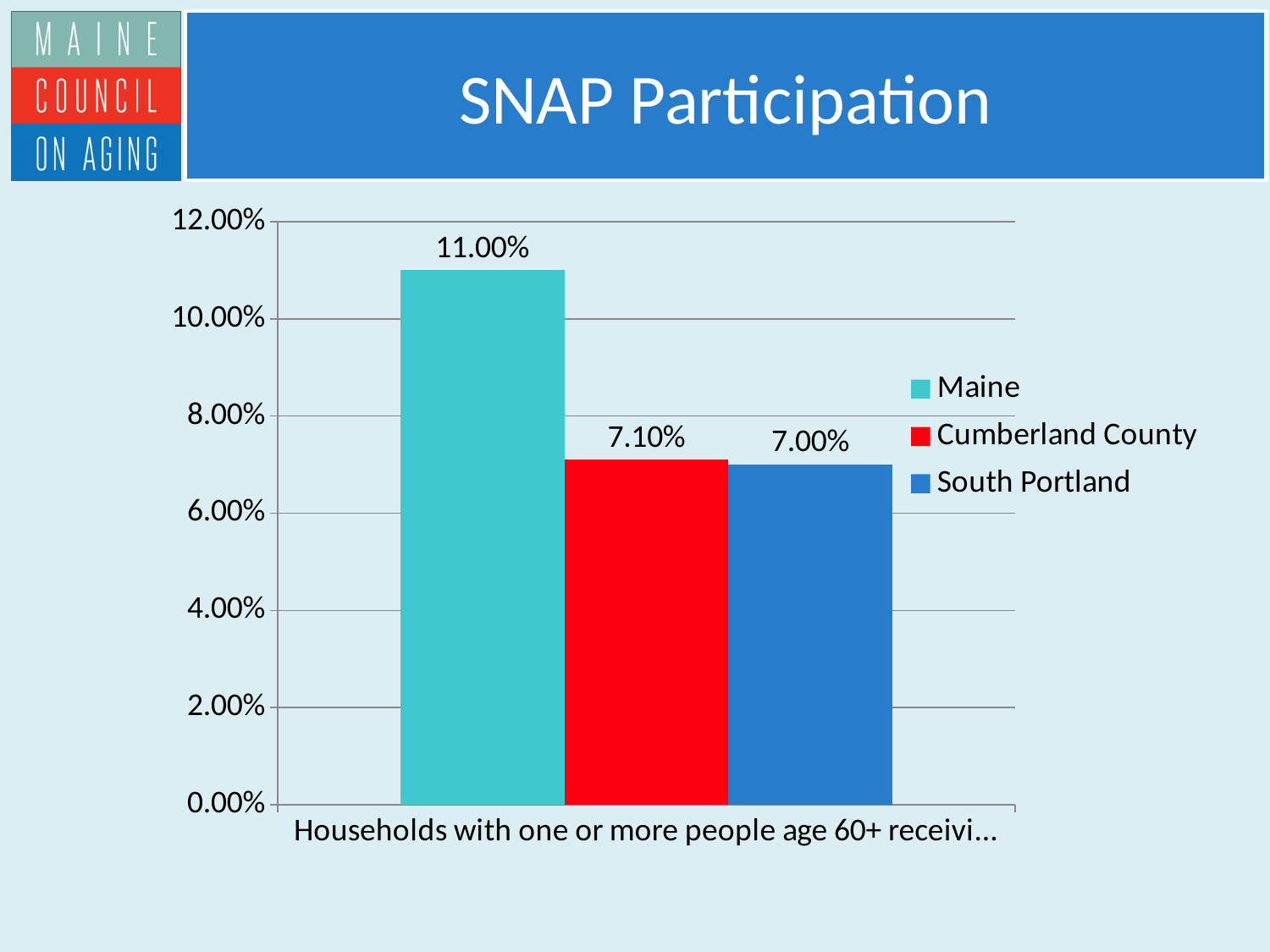
What is the value for South Portland? 7.00% Is the value for South Portland greater or less than 8.00%? less Which series has the highest value? Maine Is the value for Maine greater or less than 10.00%? greater Which is larger, the value for Maine or the value for Cumberland County? Maine What is the value for Maine? 11.00% What kind of chart is shown on the slide? bar chart What is the difference between the values for Maine and South Portland? 4.00% What is the title of the slide? SNAP Participation How many series does the legend list? 3 What is the value for Cumberland County? 7.10% What is the difference between the values for Maine and Cumberland County? 3.90%